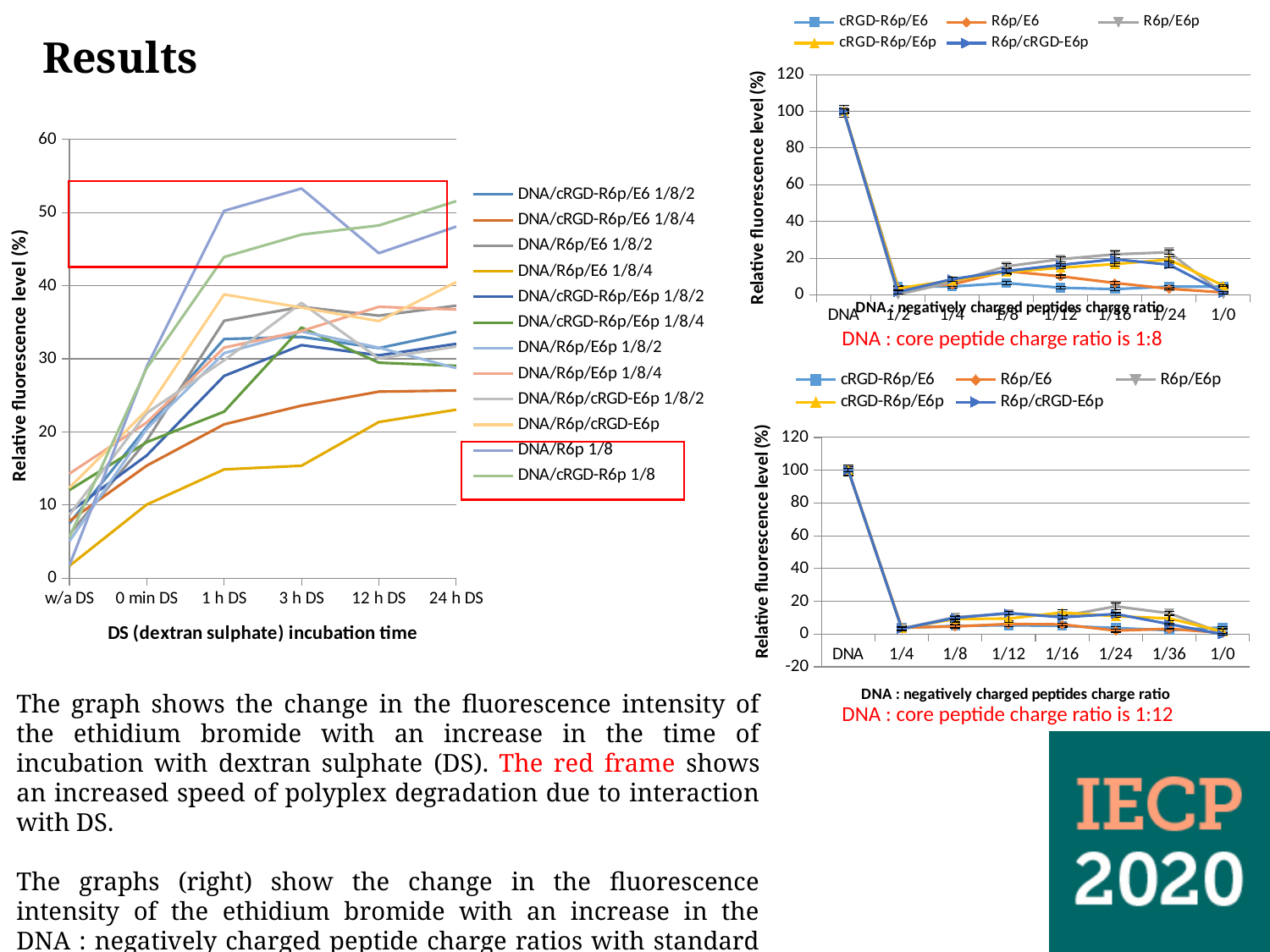
In the top-right chart (DNA : core peptide charge ratio is 1:8), what is the relative fluorescence level for the DNA category? 100 In the left chart, is the value for DNA/R6p 1/8 at 3 h DS greater or less than 50? greater In the left chart, which series has the highest value at 3 h DS? DNA/R6p 1/8 What kind of chart is the large chart on the left of the slide? line chart In the top-right chart (DNA : core peptide charge ratio is 1:8), how many categories are on the x axis? 8 In the left chart, does the DNA/R6p/E6 1/8/4 series rise or fall from w/a DS to 24 h DS? rise In the left chart, at 24 h DS, which is larger: DNA/cRGD-R6p 1/8 or DNA/R6p/E6 1/8/4? DNA/cRGD-R6p 1/8 In the left chart, how many series does the legend list? 12 In the left chart, how many DS incubation time categories are shown on the x axis? 6 In the left chart, is the value for DNA/R6p/E6 1/8/4 at 24 h DS greater or less than 30? less In the bottom-right chart (DNA : core peptide charge ratio is 1:12), how many series does the legend list? 5